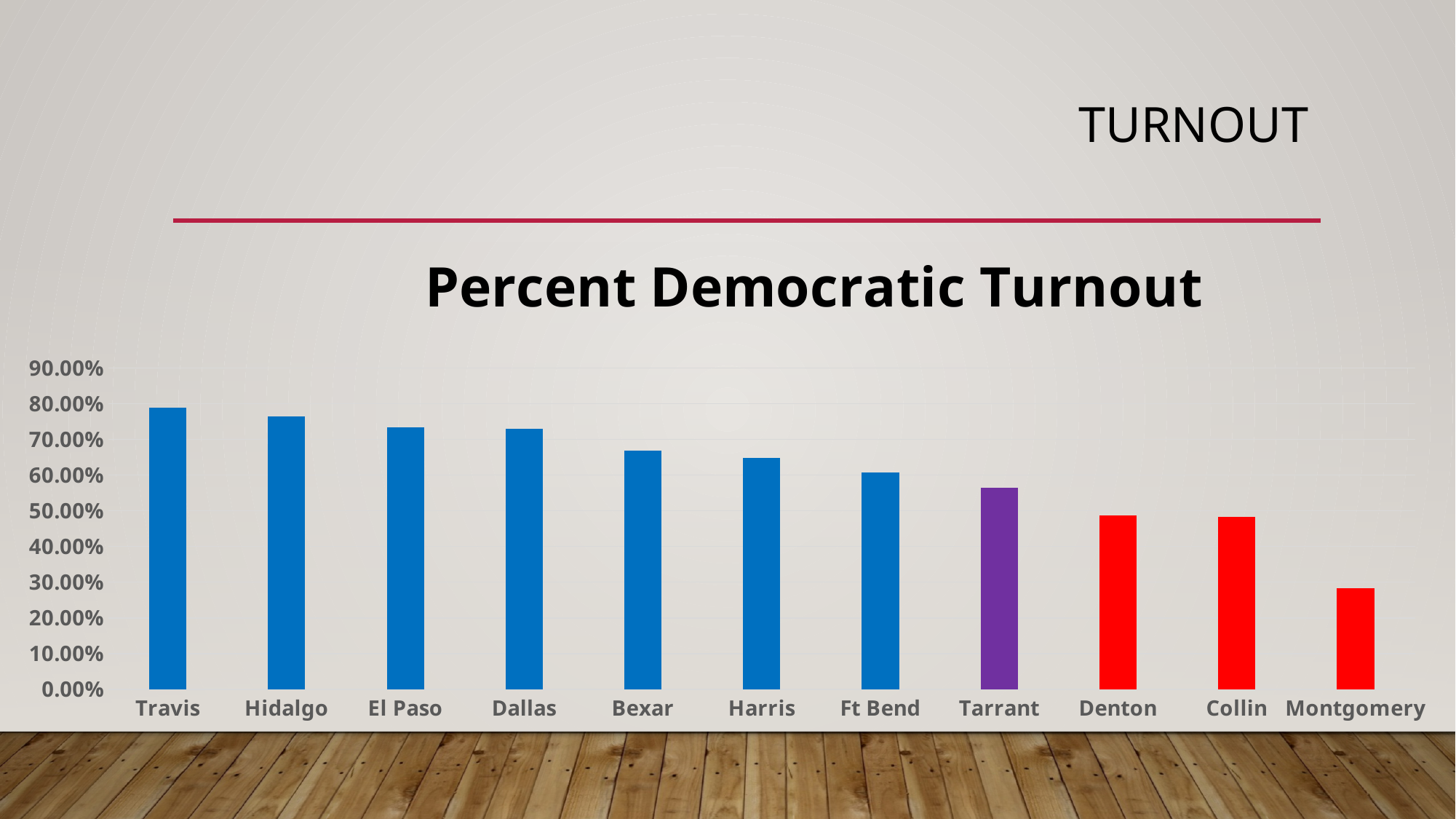
What type of chart is shown on the slide? Bar chart Is the value for Denton greater or less than 60.00%? less Which has a higher percent Democratic turnout, Bexar or Denton? Bexar What colour is the bar for Tarrant? Purple Is the value for Montgomery greater or less than 40.00%? less Is the value for Travis greater or less than 70.00%? greater Which county has the lowest percent Democratic turnout? Montgomery How many counties are shown on the x axis of the chart? 11 What is the title of the chart? Percent Democratic Turnout Do the values generally rise or fall moving from left to right along the x axis? Fall Which county has the highest percent Democratic turnout? Travis